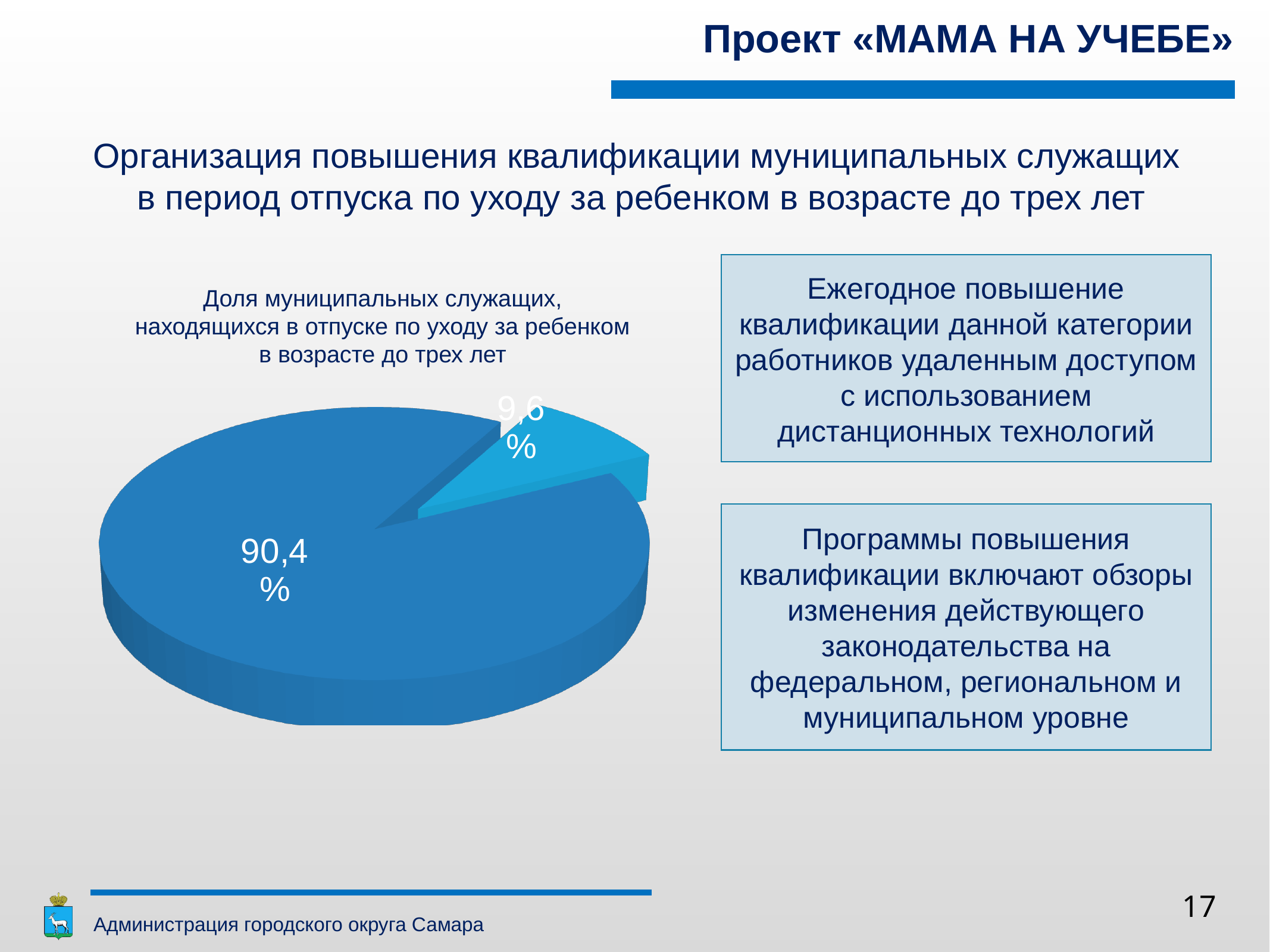
What is the difference between the two slices of the pie chart (90,4% and 9,6%)? 80,8% What is the title of the pie chart? Доля муниципальных служащих, находящихся в отпуске по уходу за ребенком в возрасте до трех лет Which slice is larger: the dark-blue slice or the light-blue pulled-out slice? the dark-blue slice What is the value of the small light-blue slice that is pulled out from the pie? 9,6% Does the pie chart have a legend? No How many slices does the pie chart have? 2 What kind of chart is shown on the slide? pie chart Is the value of the light-blue pulled-out slice greater or less than 50%? less What is the value of the smallest slice of the pie chart? 9,6% What is the value of the large dark-blue slice of the pie chart? 90,4% What is the value of the largest slice of the pie chart? 90,4% What do the two slices of the pie chart add up to? 100%